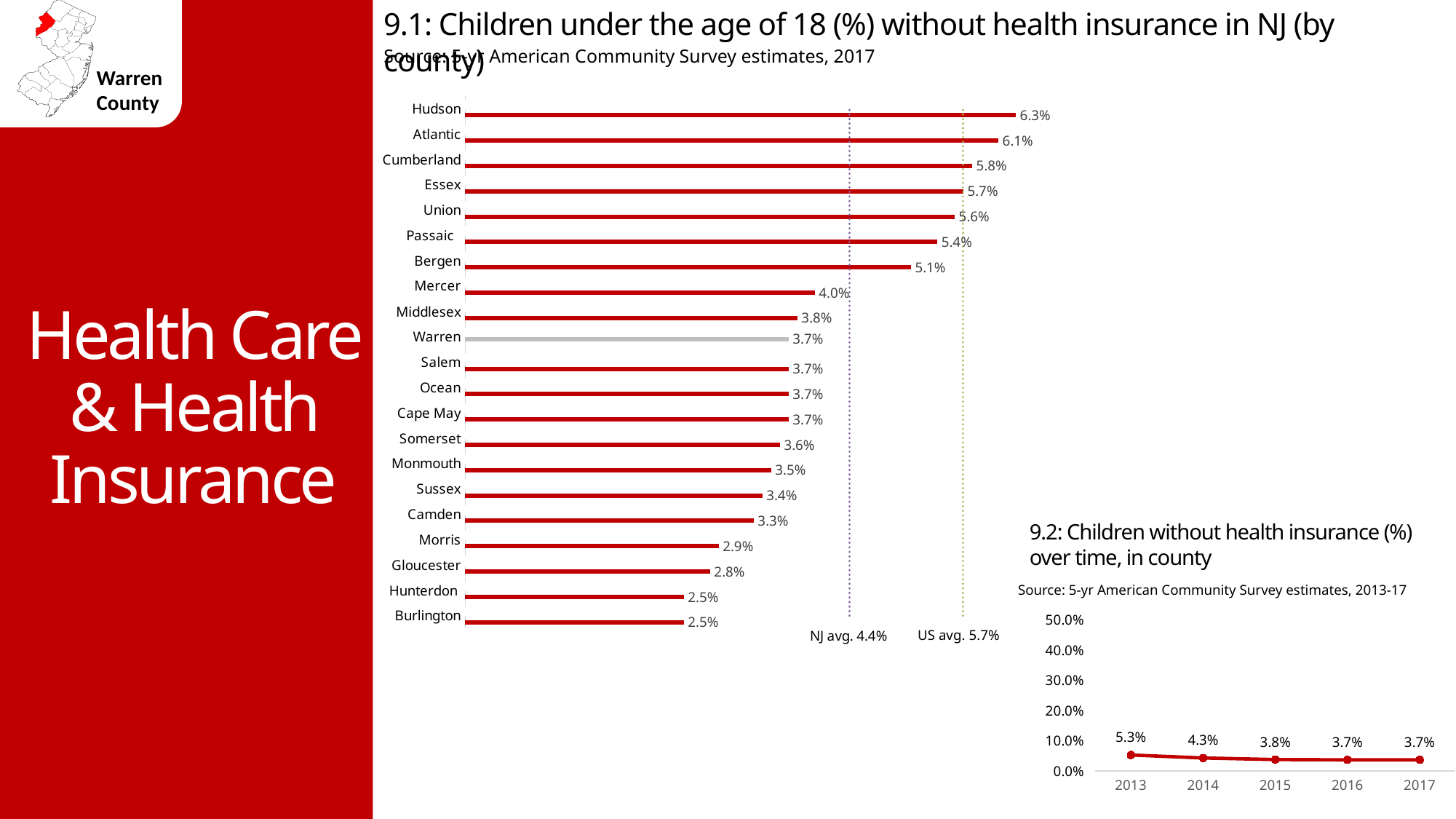
In chart 9.1, what is the NJ average shown by the dotted line? 4.4% In chart 9.2, what is the difference between the 2013 and 2017 values? 1.6% In chart 9.1, what is the value for Bergen? 5.1% What kind of chart is chart 9.1? bar chart In chart 9.1, how many counties are shown? 21 In chart 9.2, do the values rise or fall from 2013 to 2017? fall In chart 9.1 (children under 18 without health insurance by county), what is the value for Warren? 3.7% In chart 9.1, which county has the highest percentage of children without health insurance? Hudson In chart 9.1, what is the difference between Hudson and Burlington? 3.8% In chart 9.1, which is larger, the value for Passaic or the value for Mercer? Passaic What kind of chart is chart 9.2? line chart In chart 9.2 (children without health insurance over time), what is the value for 2013? 5.3%